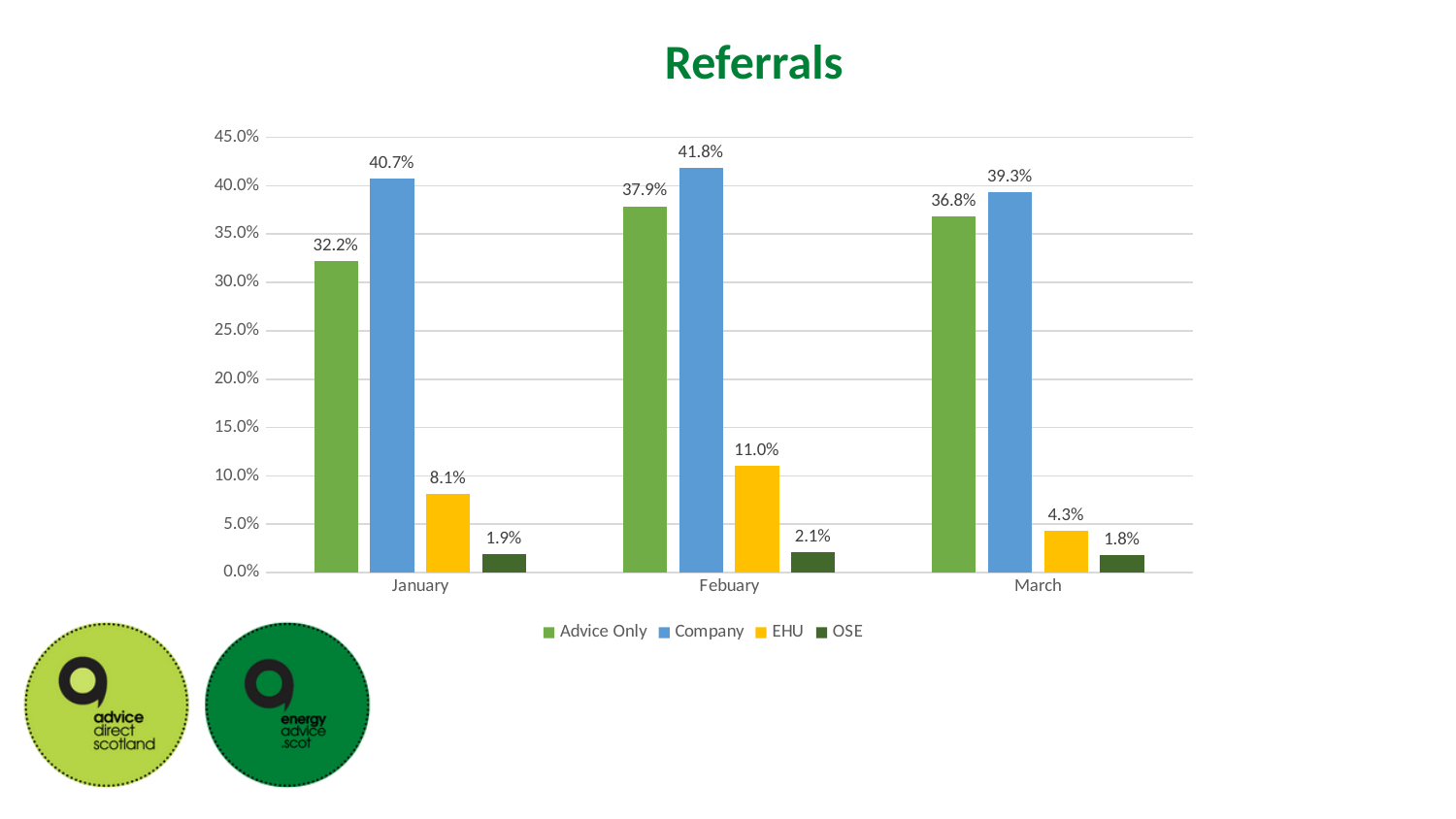
What is the value for Company in January? 40.7% What is the difference between the Company and Advice Only values in January? 8.5% What is the title of the chart? Referrals In which month is the EHU value lowest? March How many series does the legend list? 4 What is the value for EHU in Febuary? 11.0% How many months are shown on the x axis? 3 What is the value for OSE in March? 1.8% What is the value for Advice Only in March? 36.8% Which is larger in March: Advice Only or Company? Company What kind of chart is shown? Bar chart In which month is the Company value highest? Febuary